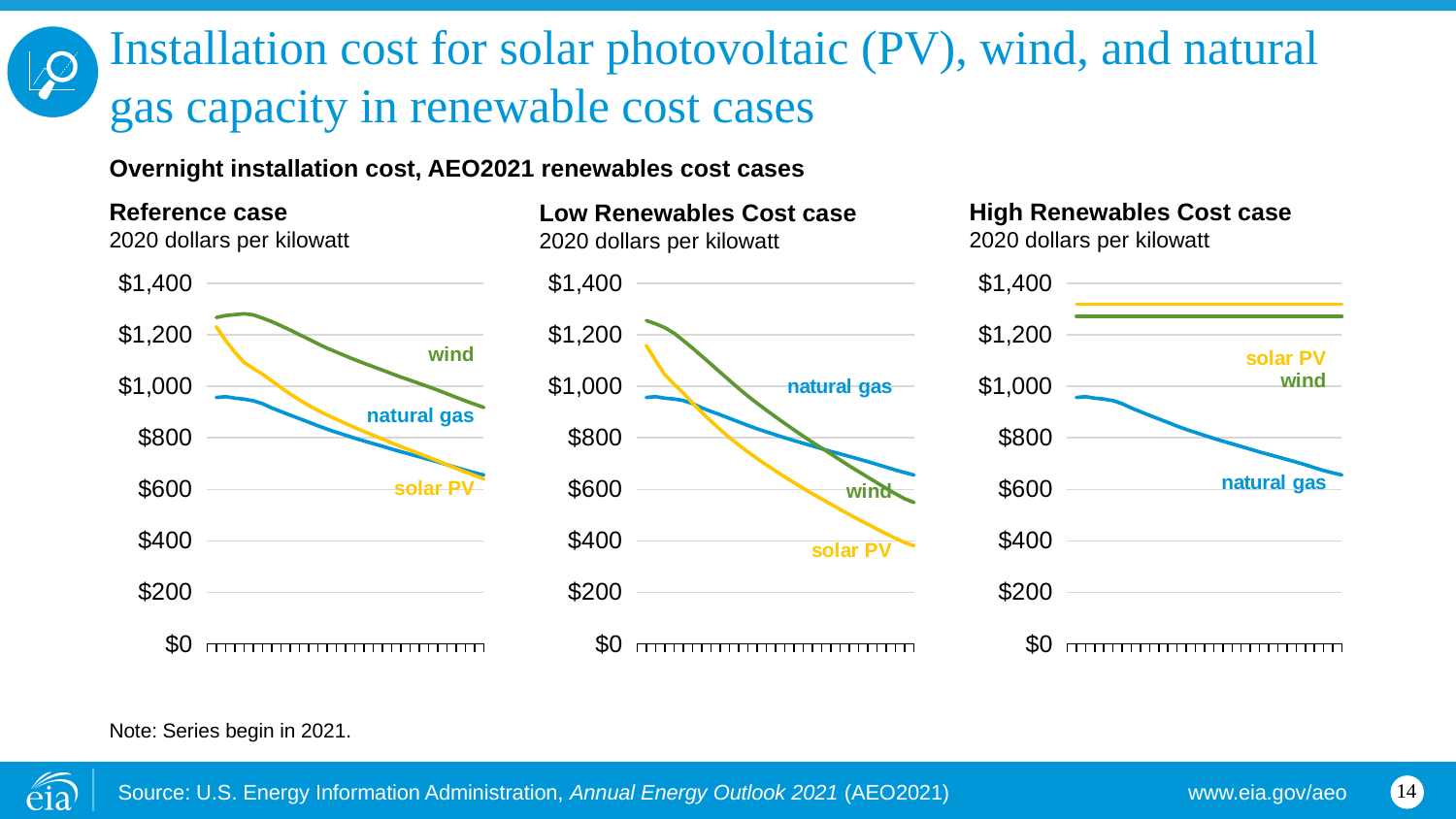
In the High Renewables Cost case chart, does the solar PV line rise, fall, or stay flat along the x axis? stay flat In the Low Renewables Cost case chart, at the end of the series, which is higher: natural gas or solar PV? natural gas In the High Renewables Cost case chart, is the value for solar PV greater or less than $1,200? greater In the High Renewables Cost case chart, does the natural gas line rise or fall along the x axis? fall How many charts are shown on the slide? 3 In the Low Renewables Cost case chart, is the final value for solar PV greater or less than $600? less In the Reference case chart, is the final value for wind greater or less than $800? greater What unit is used on the y axis of the three charts? 2020 dollars per kilowatt In the Low Renewables Cost case chart, which series ends at the lowest value? solar PV What kind of chart is used in the Reference case panel? line chart In the Reference case chart, how many series are plotted? 3 In the Reference case chart, which series ends at the highest value? wind